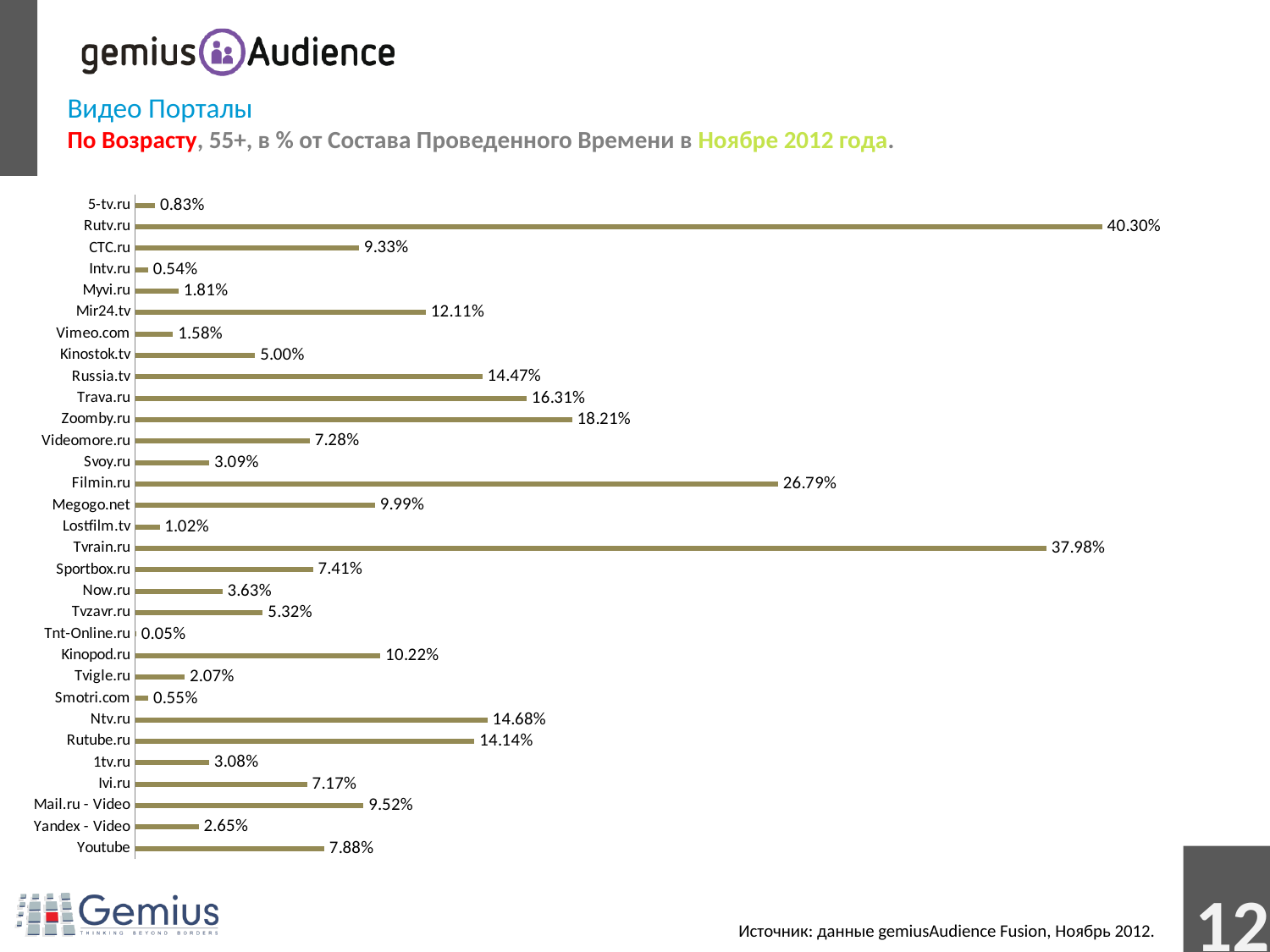
Which has a larger value, Ivi.ru or Sportbox.ru? Sportbox.ru What is the value for Youtube? 7.88% Which portal has the lowest value? Tnt-Online.ru Which portal has the highest value? Rutv.ru How many portals are shown in the chart? 31 What kind of chart is shown on the slide? Bar chart Which has a larger value, Mir24.tv or CTC.ru? Mir24.tv What is the value for Kinopod.ru? 10.22% What is the difference between the values for Zoomby.ru and Trava.ru? 1.90% What is the difference between the values for Rutv.ru and Tvrain.ru? 2.32% What is the value for Rutv.ru? 40.30% What is the value for Filmin.ru? 26.79%